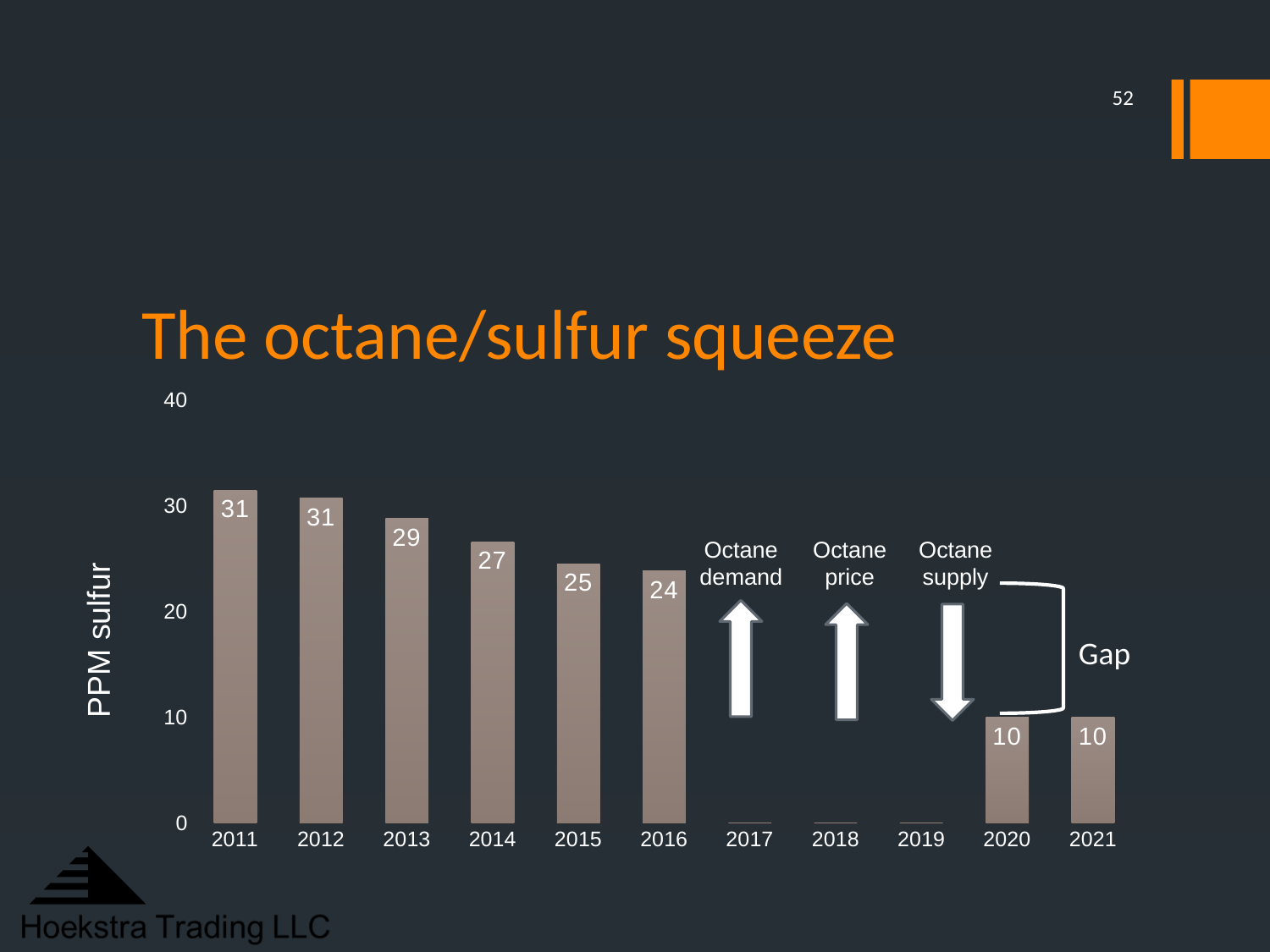
What is the PPM sulfur value for 2016? 24 What kind of chart is shown on the slide? bar chart How many years are labelled on the x axis of the chart? 11 What is the difference in PPM sulfur between 2015 and 2020? 15 Do the PPM sulfur values rise or fall from 2011 to 2016? fall What is the PPM sulfur value for 2020? 10 Which year has the lowest PPM sulfur value among the years with bars, 2015 or 2021? 2021 What is the PPM sulfur value for 2014? 27 Is the PPM sulfur value for 2021 greater or less than 20? less Is the PPM sulfur value for 2012 greater or less than 30? greater What is the PPM sulfur value for 2013? 29 What is the difference in PPM sulfur between 2011 and 2016? 7